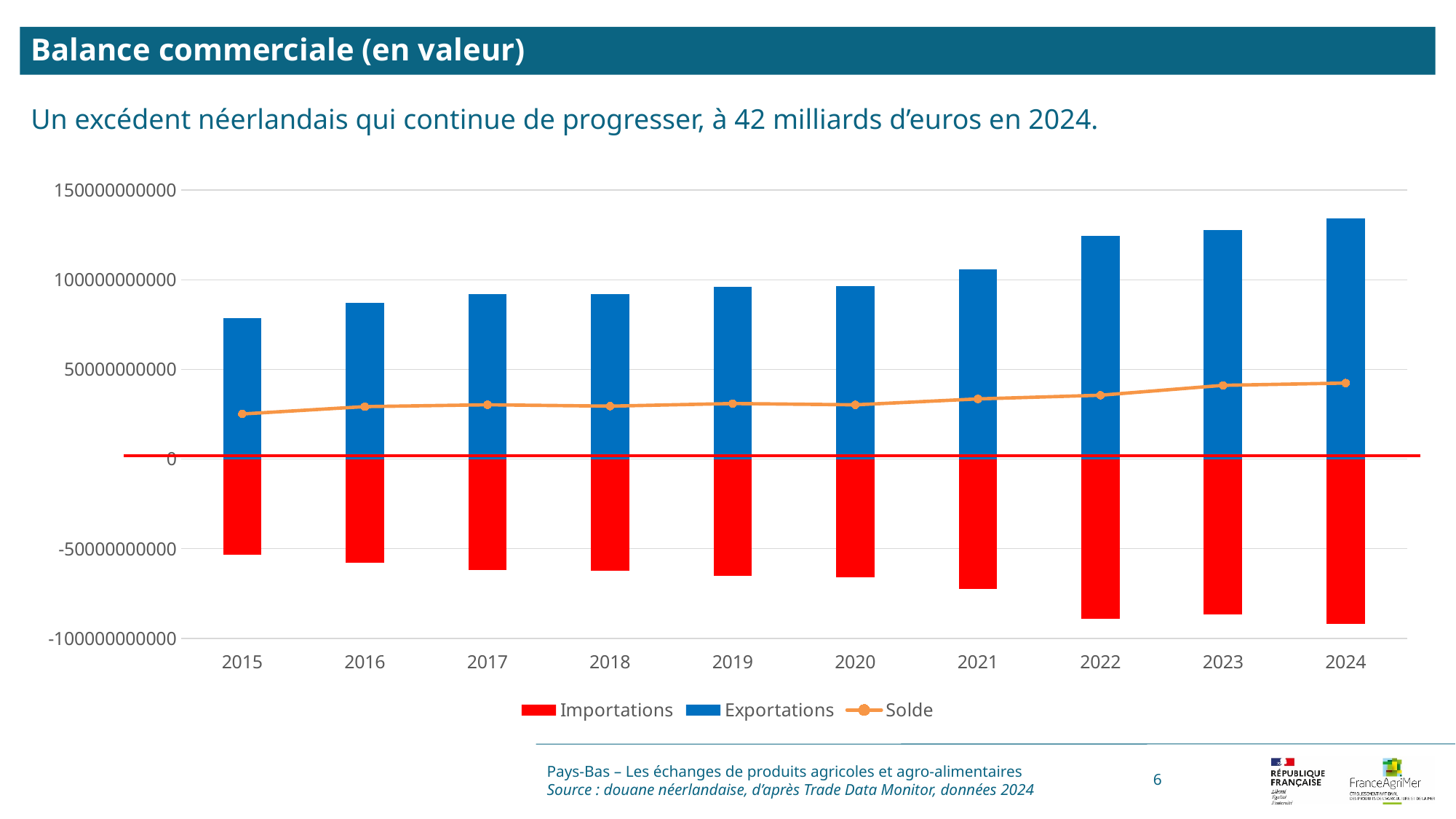
Is the Solde value for 2015 greater or less than 50000000000? less Is the Exportations value for 2024 greater or less than 100000000000? greater Which year has the lowest Solde value? 2015 Which is larger, the Exportations value for 2024 or for 2015? 2024 How many series does the chart legend list? 3 Which year has the lowest Exportations bar? 2015 Do the Exportations values rise or fall from 2015 to 2024? Rise Which year has the highest Exportations bar? 2024 How many years are shown on the x axis of the chart? 10 Is the Exportations value for 2015 greater or less than 100000000000? less What kind of chart is shown on the slide? A bar chart with a line series What colour are the Importations bars in the chart? Red